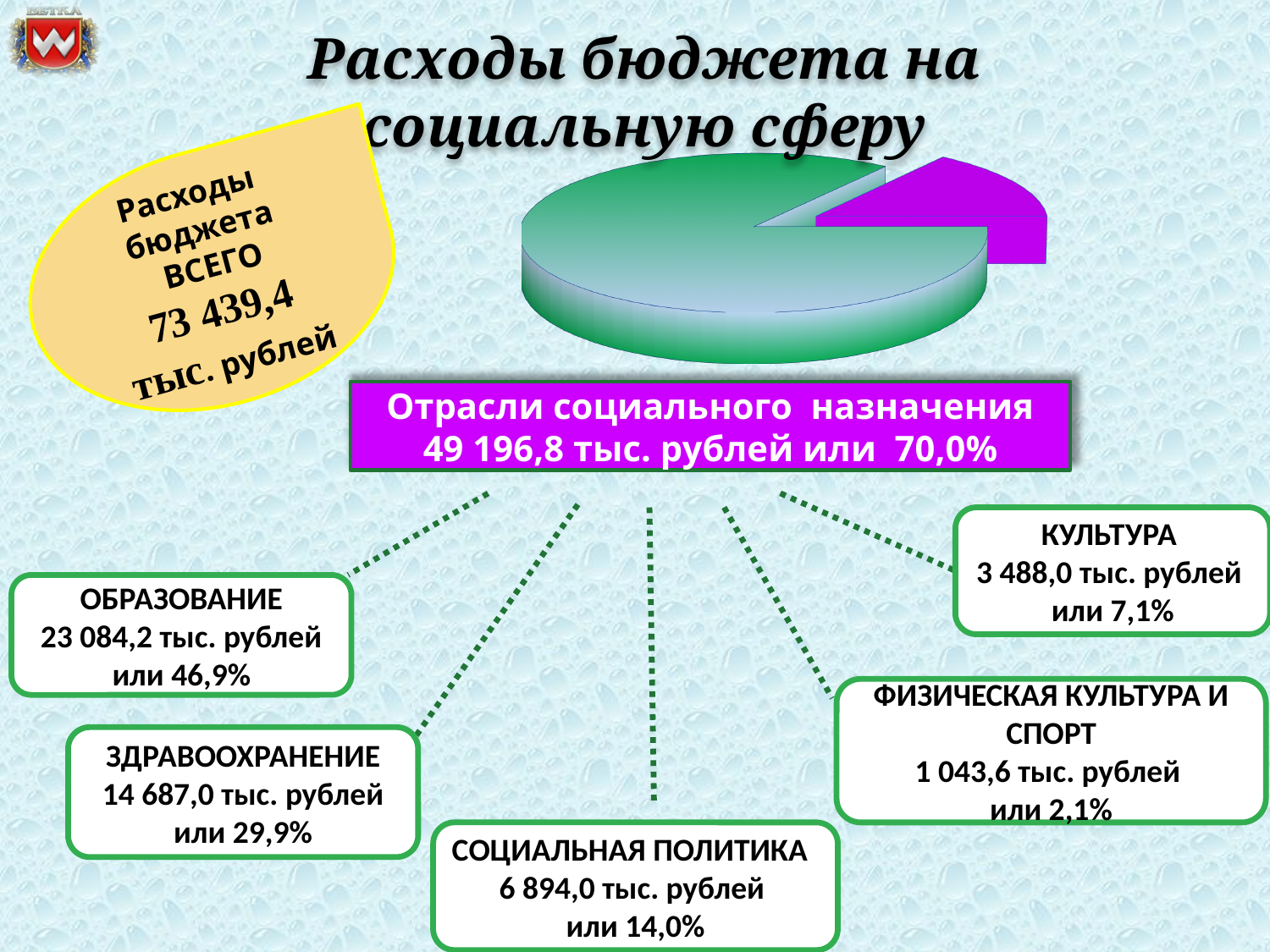
What amount is given for ОБРАЗОВАНИЕ? 23 084,2 тыс. рублей Which of the social sectors listed on the slide has the smallest expenditure? ФИЗИЧЕСКАЯ КУЛЬТУРА И СПОРТ What kind of chart is shown on the slide? pie chart What amount is given for Отрасли социального назначения? 49 196,8 тыс. рублей How many slices does the pie chart have? 2 Which slice of the pie chart is larger, the green one or the purple one? the green one By how many percentage points does the share of ОБРАЗОВАНИЕ exceed the share of ЗДРАВООХРАНЕНИЕ? 17,0% Which of the social sectors listed on the slide has the largest expenditure? ОБРАЗОВАНИЕ What percentage is shown for ЗДРАВООХРАНЕНИЕ? 29,9% What is the difference between the amounts for КУЛЬТУРА and ФИЗИЧЕСКАЯ КУЛЬТУРА И СПОРТ? 2 444,4 тыс. рублей What is the total budget expenditure (Расходы бюджета ВСЕГО) shown on the slide? 73 439,4 тыс. рублей What share of the total budget do Отрасли социального назначения make up, according to the slide? 70,0%